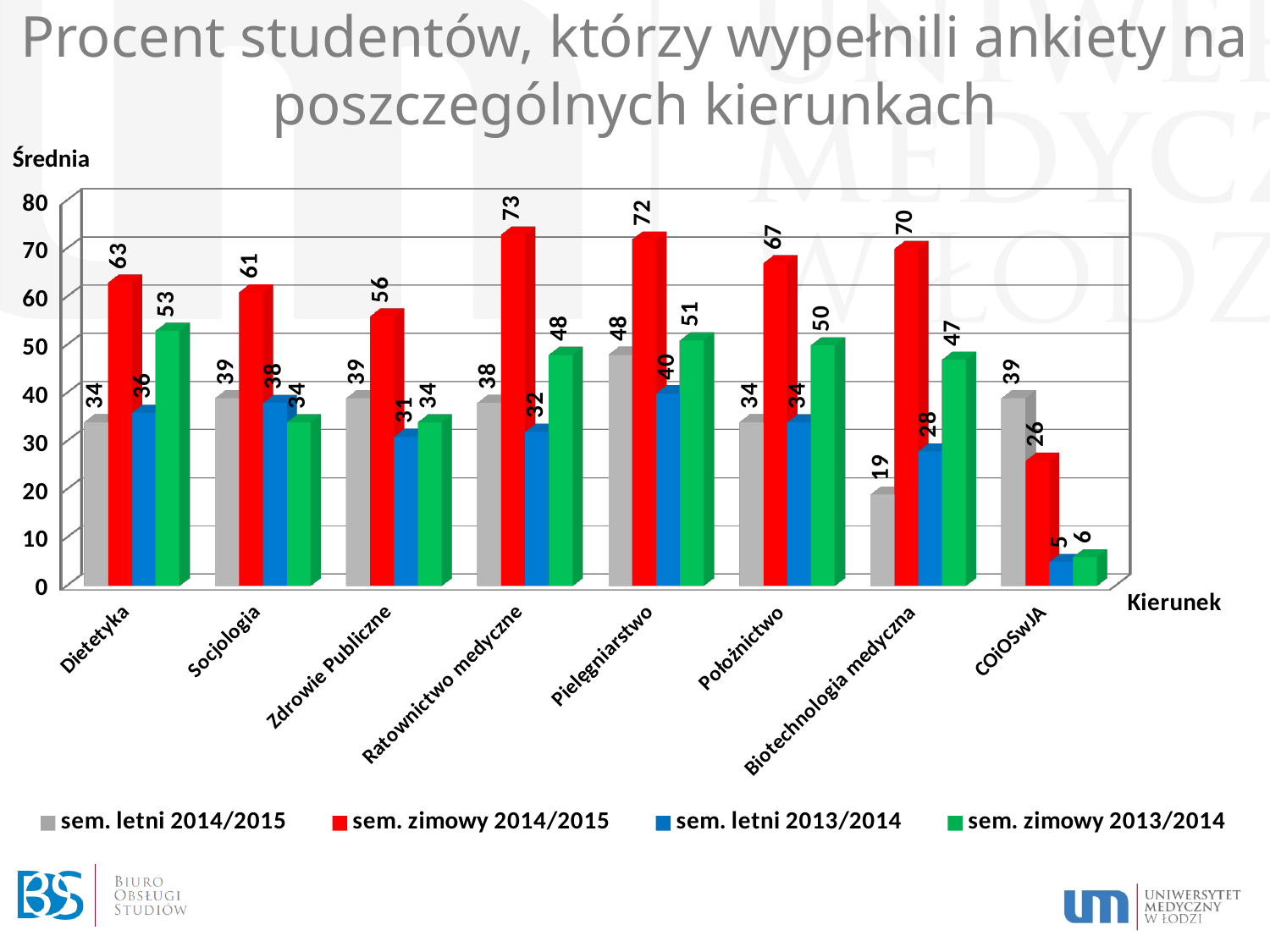
Which colour represents the sem. letni 2013/2014 series? blue What is the difference between the sem. zimowy 2014/2015 and sem. letni 2014/2015 values for Dietetyka? 29 What is the value for Biotechnologia medyczna in the sem. letni 2014/2015 series? 19 What is the value for Ratownictwo medyczne in the sem. zimowy 2014/2015 series? 73 What is the value for COiOSwJA in the sem. zimowy 2013/2014 series? 6 Which category has the highest value in the sem. zimowy 2014/2015 series? Ratownictwo medyczne Is the value for Położnictwo in the sem. zimowy 2014/2015 series greater or less than 60? greater How many categories (kierunki) are shown on the x axis? 8 Which category has the lowest value in the sem. letni 2013/2014 series? COiOSwJA How many series does the legend list? 4 What kind of chart is shown on the slide? bar chart For Pielęgniarstwo, which is larger: the sem. letni 2014/2015 value or the sem. zimowy 2013/2014 value? sem. zimowy 2013/2014